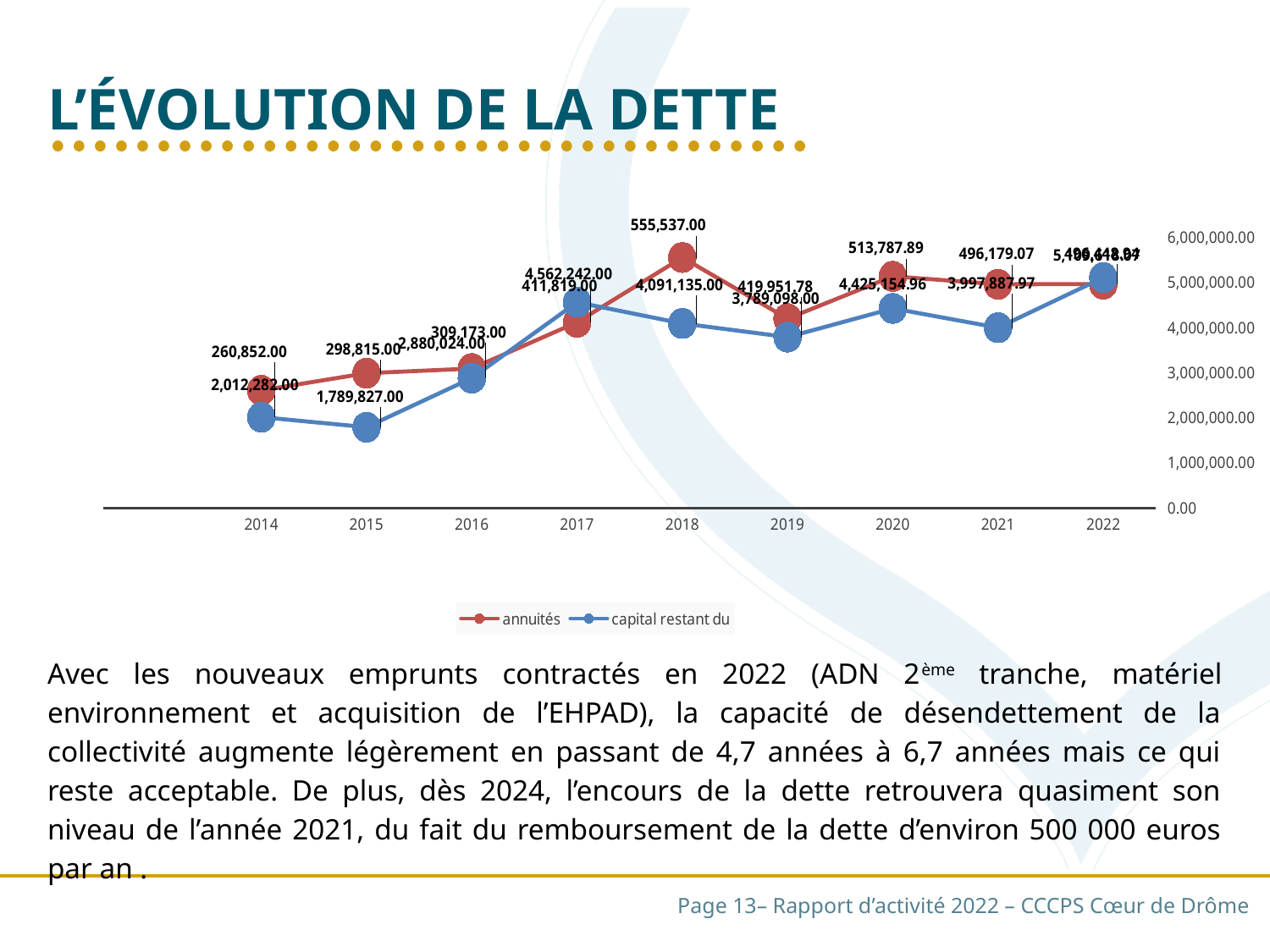
What kind of chart is shown on the slide? line chart What is the value of annuités in 2018? 555,537.00 What is the value of annuités in 2019? 419,951.78 What is the value of capital restant du in 2017? 4,562,242.00 In which year is the capital restant du lowest? 2015 What is the difference between capital restant du in 2017 and in 2018? 471,107.00 How many years are shown on the x axis? 9 Which year has the larger annuités value, 2020 or 2021? 2020 Is the value of capital restant du in 2022 greater or less than 5,000,000.00? greater In which year are the annuités highest? 2018 How many series does the legend list? 2 Does the capital restant du rise or fall from 2014 to 2017? rise